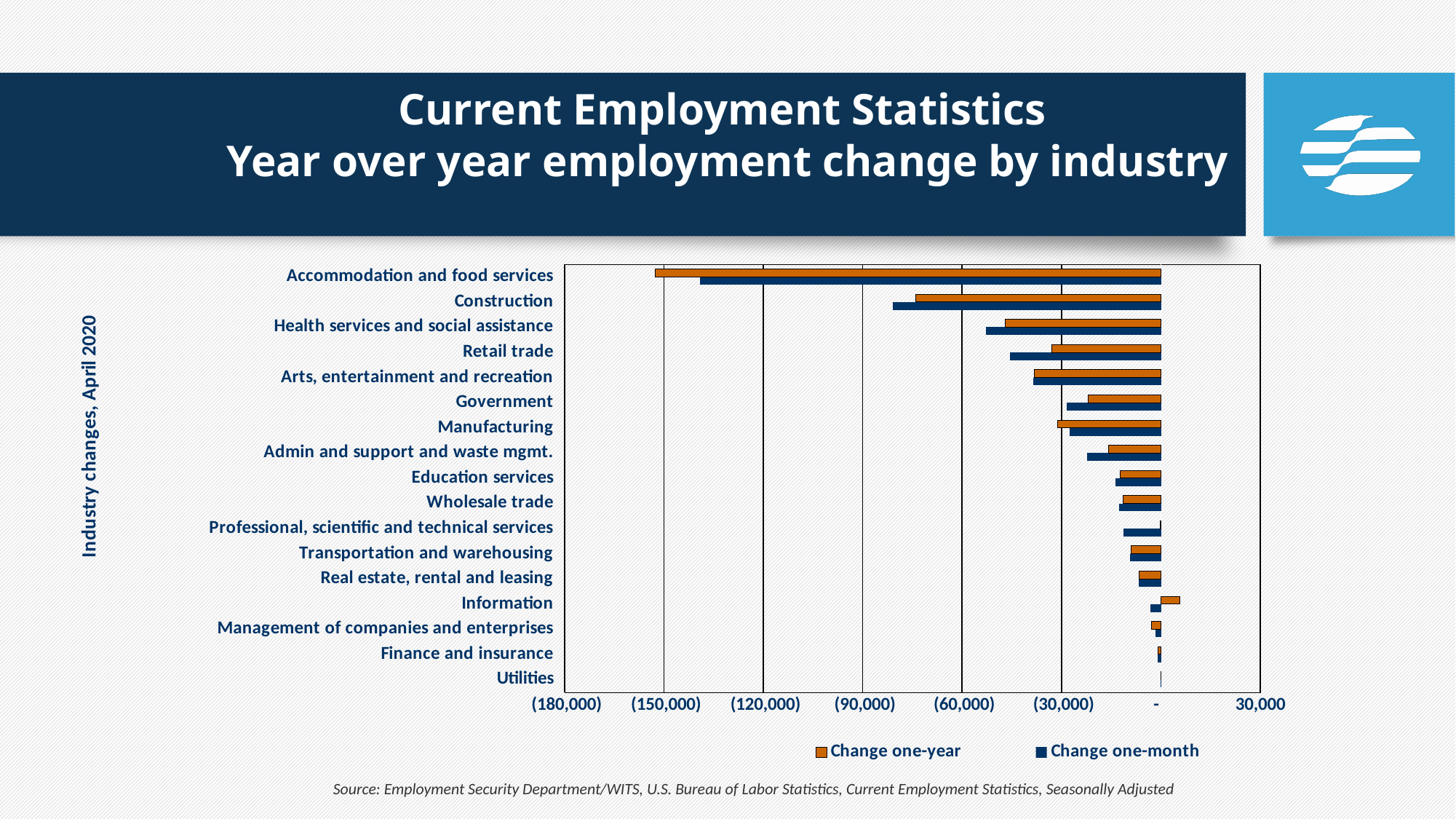
Which has the larger one-year employment decline, Construction or Health services and social assistance? Construction How many industry categories are plotted on the chart? 17 Which industry is the only one with a positive one-year employment change? Information What is the label on the vertical axis of the chart? Industry changes, April 2020 Is the one-year change for Construction greater or less than (60,000)? less Is the one-year change for Health services and social assistance greater or less than (30,000)? less Is the one-year change for Government greater or less than (30,000)? greater Which industry shows the largest one-year employment decline? Accommodation and food services Which industry shows the largest one-month employment decline? Accommodation and food services How many series does the chart legend list? 2 What kind of chart is shown on the slide? Bar chart Which series is shown in orange in the legend? Change one-year